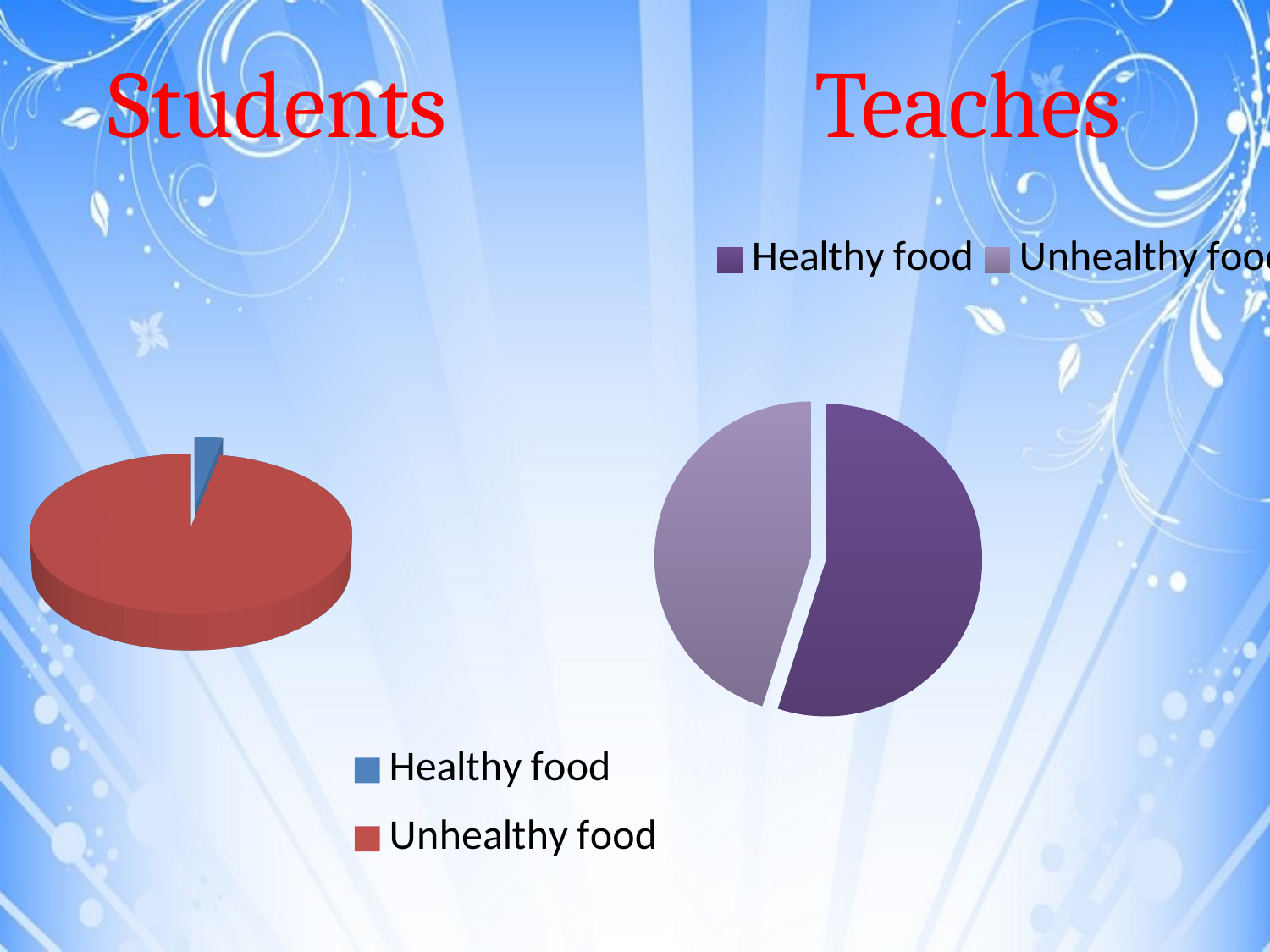
In the Students chart, which category has the smallest slice? Healthy food How many slices does the Students pie chart have? 2 In the Students chart, which category has the largest slice? Unhealthy food What kind of chart is the Students chart? pie chart What kind of chart is the Teaches chart? pie chart In the Students chart, which is larger: Healthy food or Unhealthy food? Unhealthy food How many slices does the Teaches pie chart have? 2 In the Teaches chart, which category has the larger slice? Healthy food In the Teaches chart, which category has the smaller slice? Unhealthy food What colour is the Unhealthy food slice in the Students chart? red What are the two legend entries of the Students chart? Healthy food, Unhealthy food In the Teaches chart, which is larger: Healthy food or Unhealthy food? Healthy food